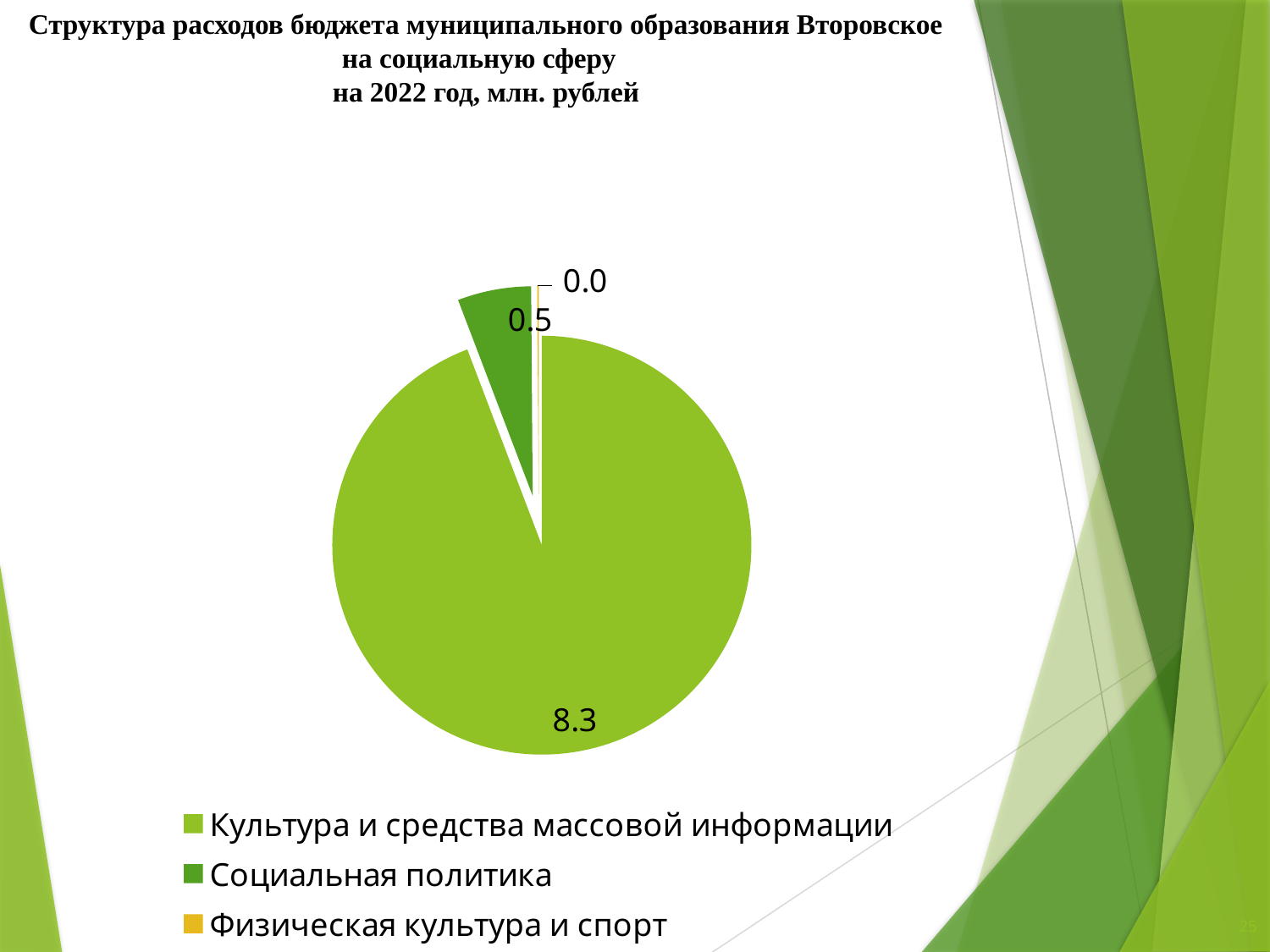
What unit of measurement is stated in the chart title? млн. рублей What kind of chart is shown on the slide? pie chart How many categories does the pie chart show? 3 What is the value for Социальная политика? 0.5 Which is larger: the value for Социальная политика or the value for Физическая культура и спорт? Социальная политика Which year does the chart title refer to? 2022 Which category has the largest slice of the pie? Культура и средства массовой информации Which category has the smallest slice of the pie? Физическая культура и спорт What is the value for Физическая культура и спорт? 0.0 What is the total of all the values shown in the pie chart? 8.8 What is the value for Культура и средства массовой информации? 8.3 What is the difference between the values for Культура и средства массовой информации and Социальная политика? 7.8